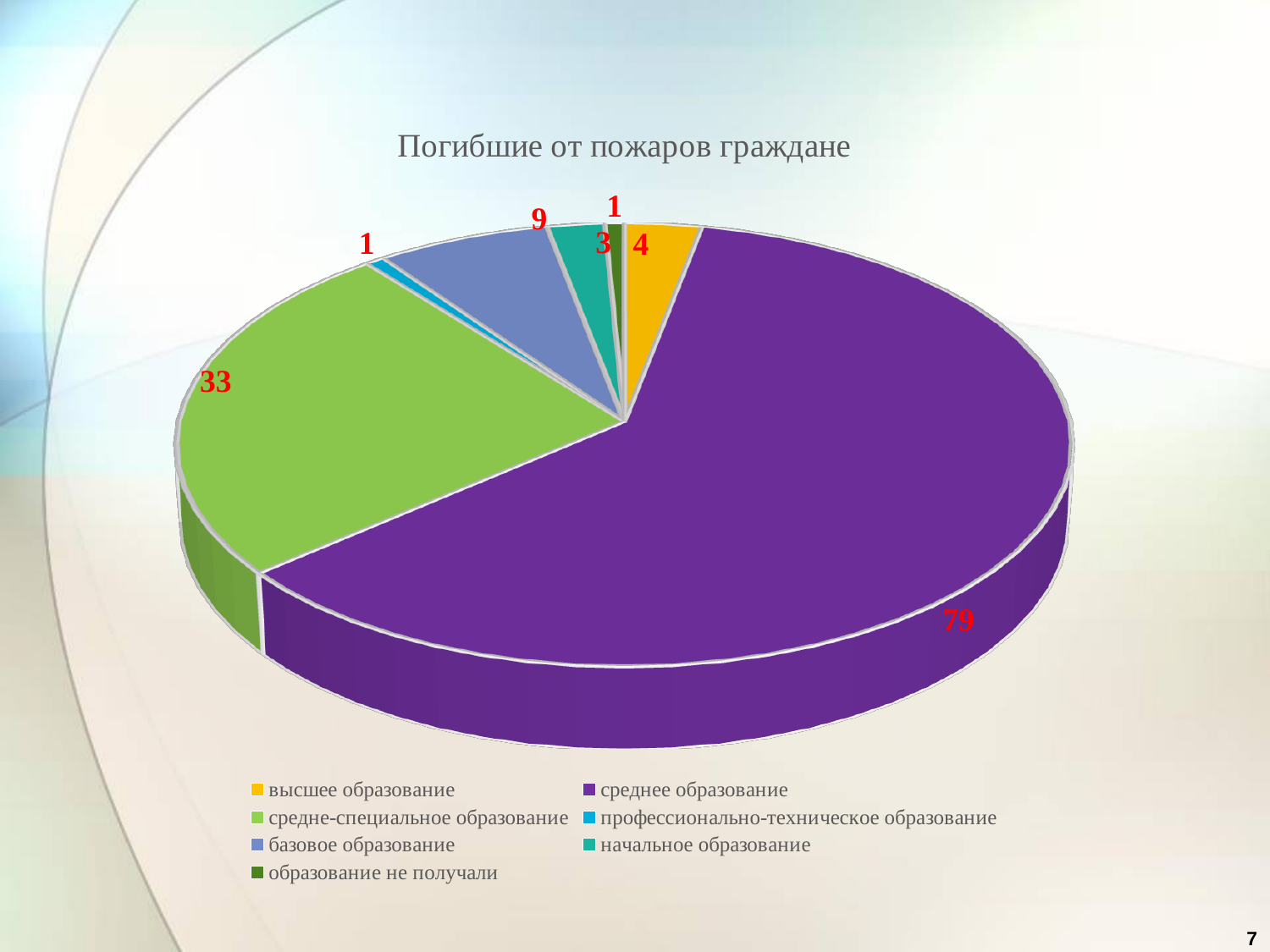
What is the value for базовое образование? 9 Which category has the largest slice of the pie? среднее образование What colour is the slice for среднее образование? purple What is the value for начальное образование? 3 What kind of chart is shown on the slide? pie chart How many categories does the legend of the chart list? 7 What is the value for среднее образование? 79 What is the title of the chart? Погибшие от пожаров граждане What is the value for средне-специальное образование? 33 What is the difference between the values for среднее образование and средне-специальное образование? 46 Which is larger, the value for базовое образование or the value for высшее образование? базовое образование What is the value for высшее образование? 4